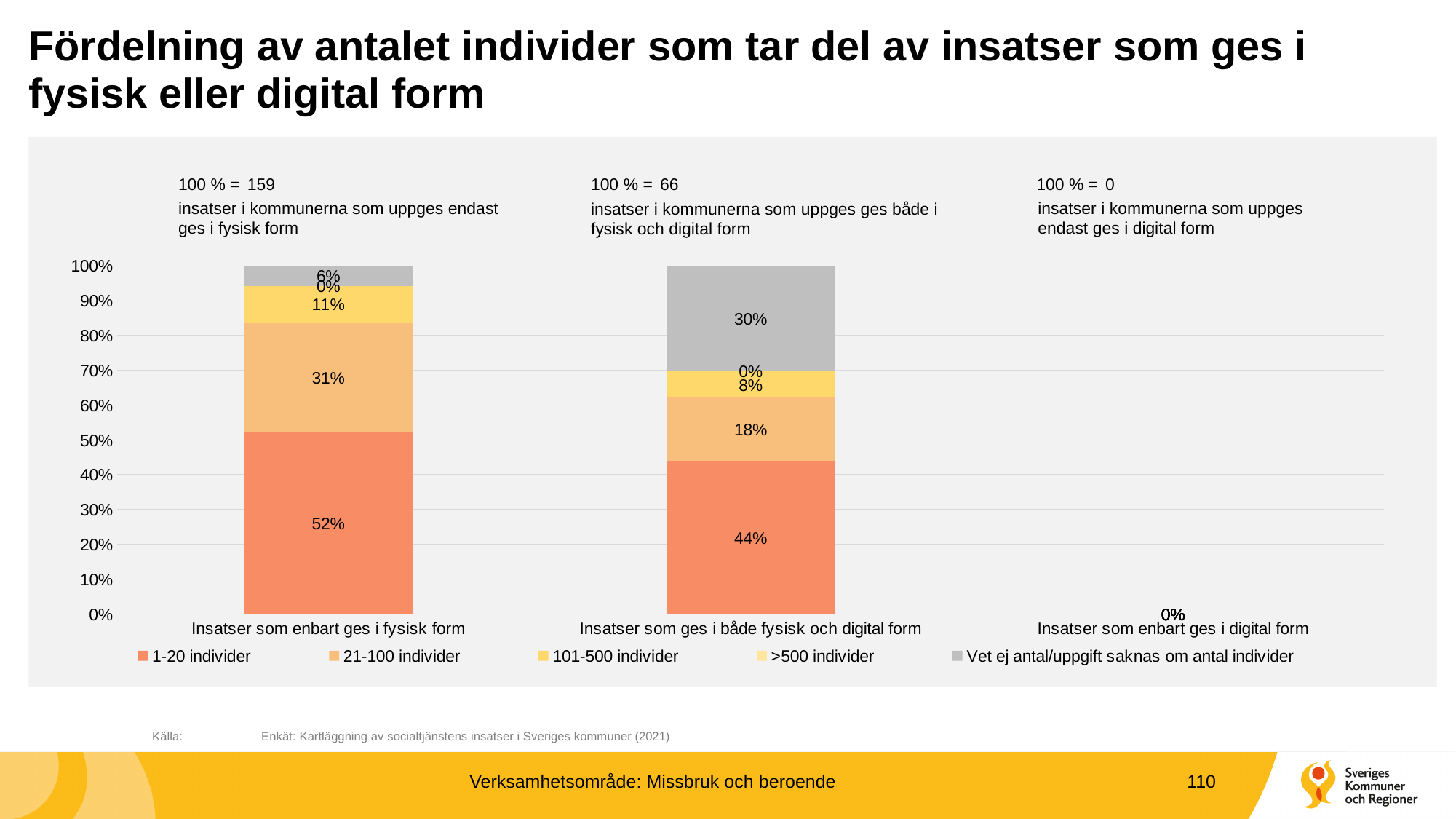
Which is larger: the 'Vet ej antal/uppgift saknas om antal individer' value for 'Insatser som enbart ges i fysisk form' or for 'Insatser som ges i både fysisk och digital form'? Insatser som ges i både fysisk och digital form Which series in the legend is shown in grey? Vet ej antal/uppgift saknas om antal individer According to the note above the chart, how many insatser does 100 % correspond to for the category 'Insatser som ges i både fysisk och digital form'? 66 What is the value for '1-20 individer' in the category 'Insatser som enbart ges i fysisk form'? 52% Which category has the highest value for '1-20 individer'? Insatser som enbart ges i fysisk form What is the value for 'Vet ej antal/uppgift saknas om antal individer' in the category 'Insatser som ges i både fysisk och digital form'? 30% What is the difference between the '21-100 individer' values for 'Insatser som enbart ges i fysisk form' and 'Insatser som ges i både fysisk och digital form'? 13% How many categories are shown on the x axis? 3 What is the value for '101-500 individer' in the category 'Insatser som enbart ges i fysisk form'? 11% How many series does the legend list? 5 What kind of chart is shown on the slide? stacked bar chart What is the value for '21-100 individer' in the category 'Insatser som ges i både fysisk och digital form'? 18%